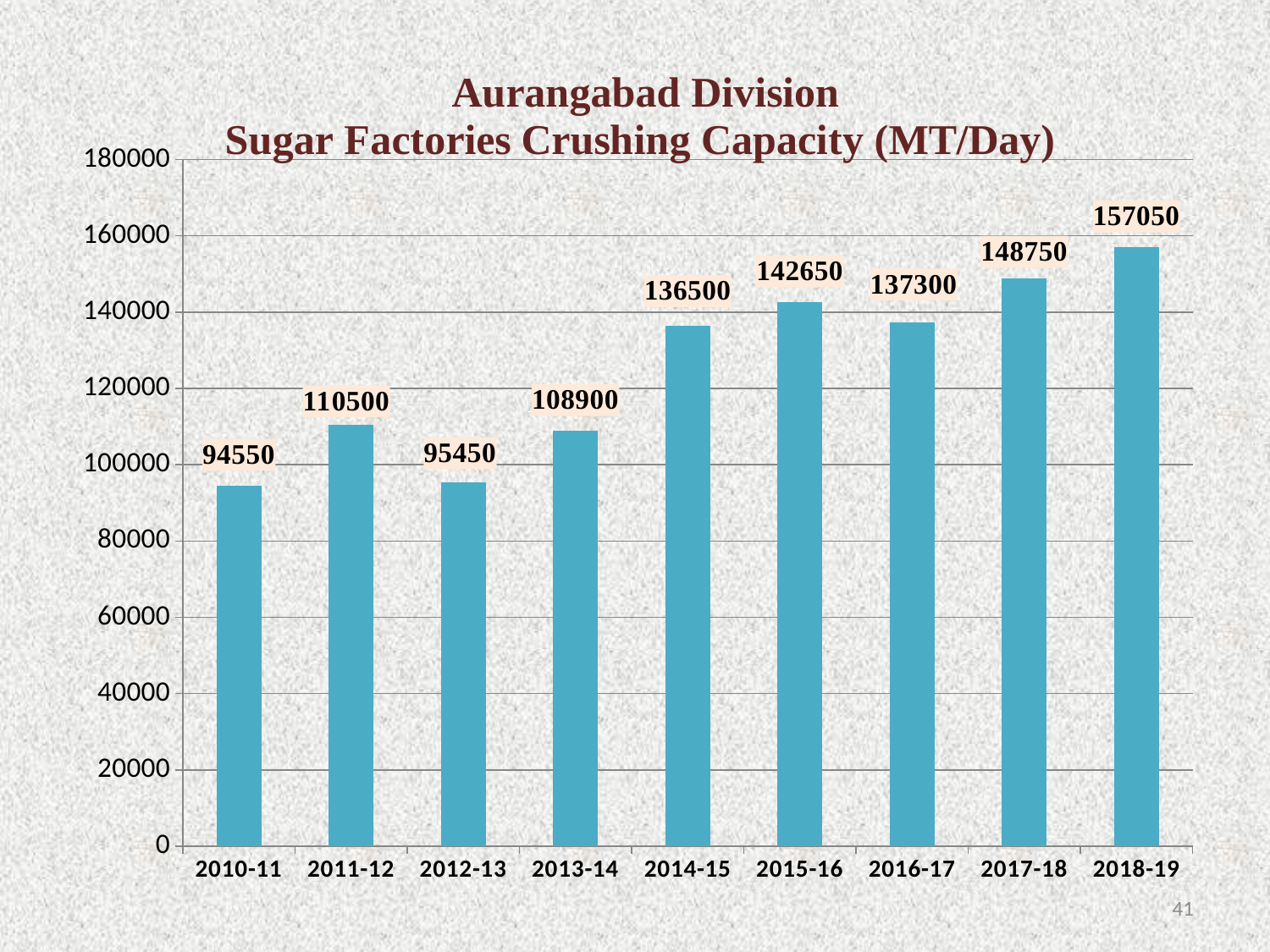
What is the crushing capacity for 2017-18? 148750 Is the crushing capacity for 2014-15 greater or less than 120000? greater What is the crushing capacity for 2010-11? 94550 Which year has the lowest crushing capacity? 2010-11 What is the title of the chart? Aurangabad Division Sugar Factories Crushing Capacity (MT/Day) Which year has a larger crushing capacity, 2011-12 or 2013-14? 2011-12 How many years are shown on the chart? 9 Which year has the highest crushing capacity? 2018-19 What is the crushing capacity for 2015-16? 142650 What is the difference in crushing capacity between 2018-19 and 2010-11? 62500 What is the difference in crushing capacity between 2015-16 and 2016-17? 5350 What kind of chart is shown on the slide? Bar chart